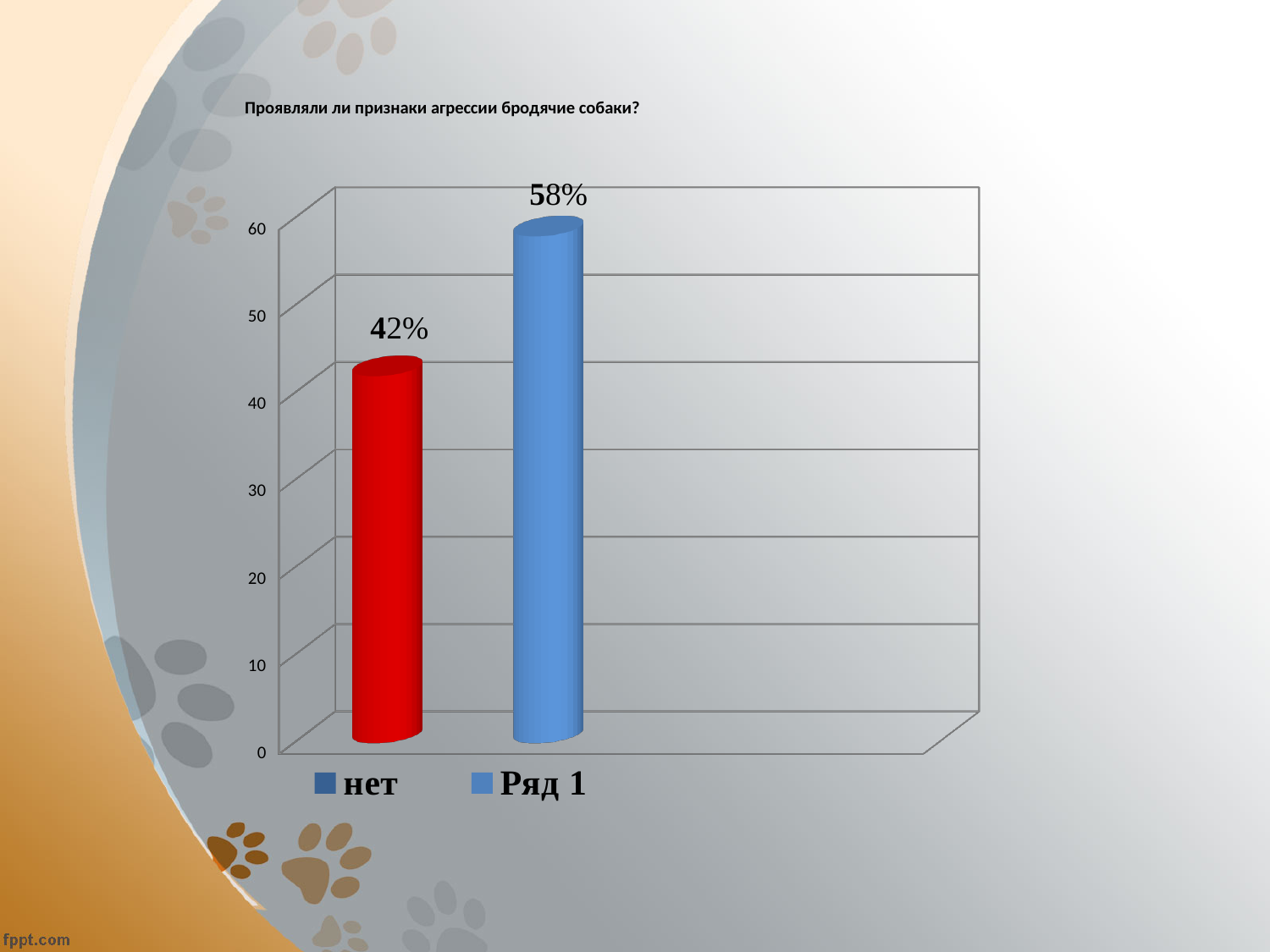
Is the value for the blue bar greater or less than 50? greater What kind of chart is shown on the slide? bar chart Which bar is the tallest, the red one or the blue one? the blue bar What is the value shown on the red bar? 42% How many bars are plotted on the chart? 2 What is the title of the chart? Проявляли ли признаки агрессии бродячие собаки? Which bar has the lowest value? the red bar Is the value for the red bar greater or less than 50? less How many entries does the legend list? 2 Is the value of the red bar larger or smaller than the value of the blue bar? smaller What is the value shown on the blue bar? 58% What is the difference between the blue bar's value and the red bar's value? 16%